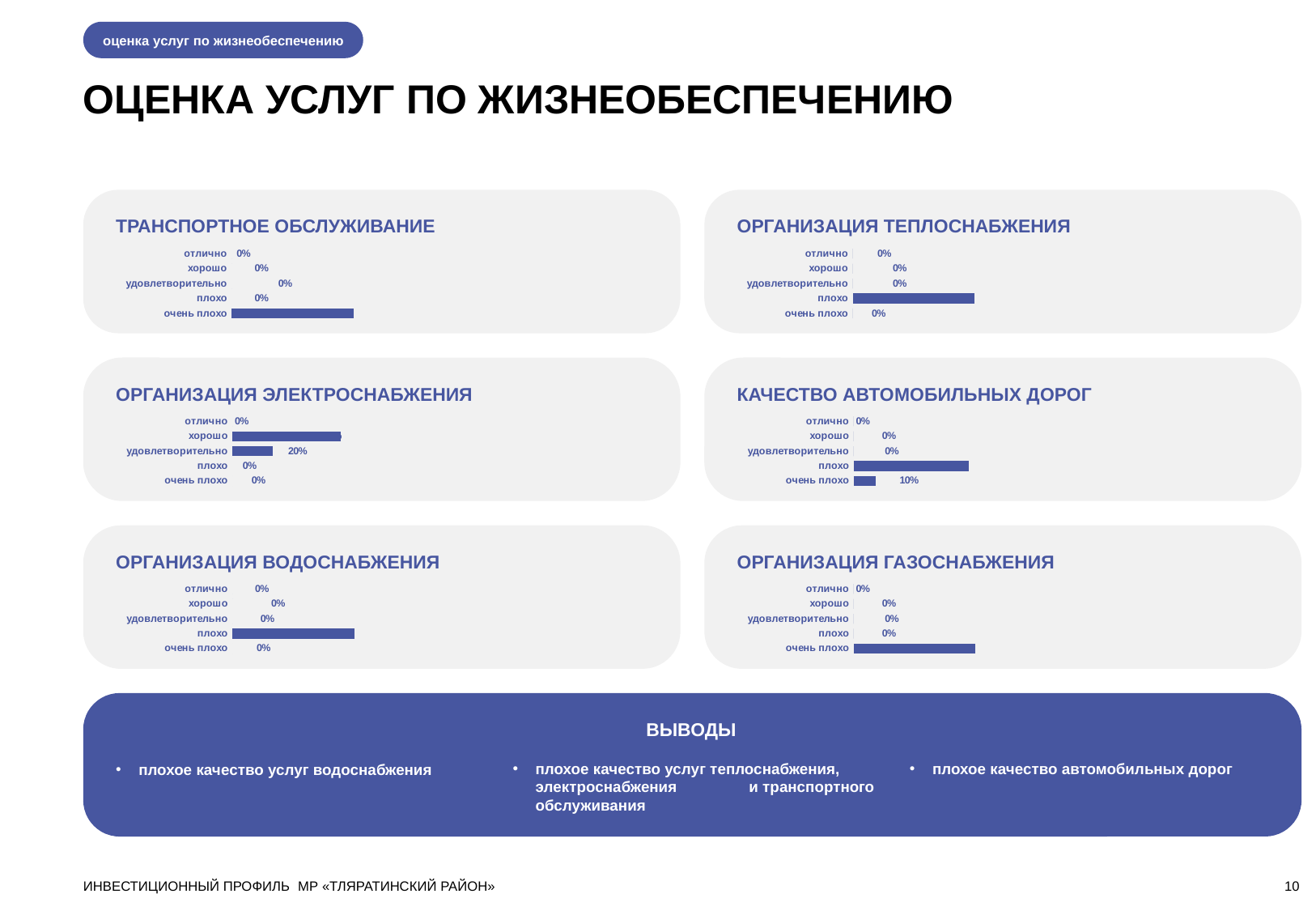
In the 'ОРГАНИЗАЦИЯ ТЕПЛОСНАБЖЕНИЯ' chart, which category has the highest value? плохо How many categories does the 'ОРГАНИЗАЦИЯ ВОДОСНАБЖЕНИЯ' chart show? 5 In the 'ОРГАНИЗАЦИЯ ЭЛЕКТРОСНАБЖЕНИЯ' chart, what is the value for 'удовлетворительно'? 20% In the 'КАЧЕСТВО АВТОМОБИЛЬНЫХ ДОРОГ' chart, which is larger: 'плохо' or 'очень плохо'? плохо In the 'ТРАНСПОРТНОЕ ОБСЛУЖИВАНИЕ' chart, which category has the highest value? очень плохо In the 'КАЧЕСТВО АВТОМОБИЛЬНЫХ ДОРОГ' chart, what is the value for 'очень плохо'? 10% In the 'ОРГАНИЗАЦИЯ ВОДОСНАБЖЕНИЯ' chart, which category has the highest value? плохо In the 'ОРГАНИЗАЦИЯ ГАЗОСНАБЖЕНИЯ' chart, what is the value for 'отлично'? 0% In the 'ТРАНСПОРТНОЕ ОБСЛУЖИВАНИЕ' chart, what is the value for 'плохо'? 0% What type of chart is the 'ОРГАНИЗАЦИЯ ТЕПЛОСНАБЖЕНИЯ' chart? bar chart